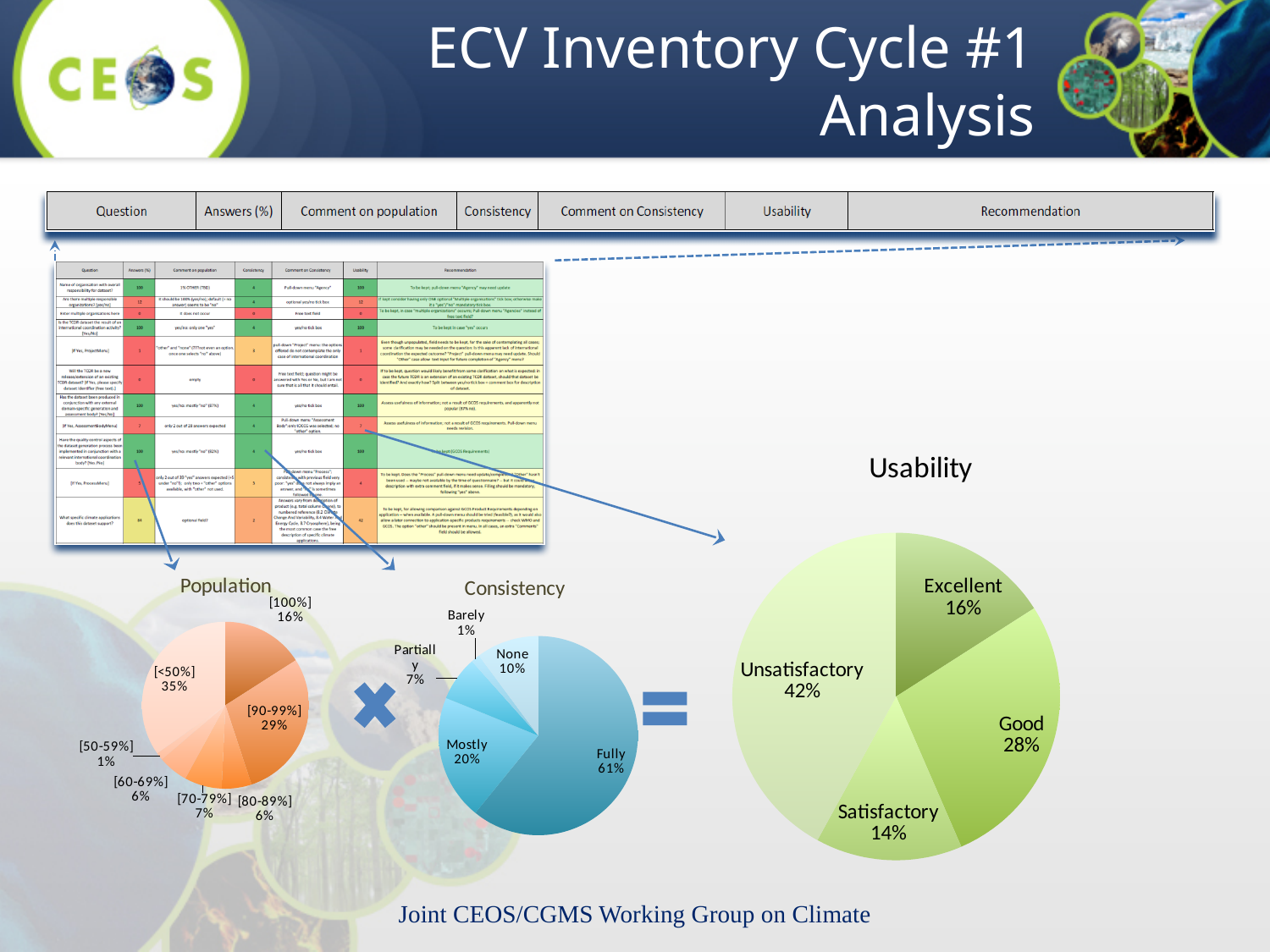
How many slices does the Consistency pie chart have? 5 In the Usability pie chart, which category has the largest share? Unsatisfactory In the Usability pie chart, which category has the smallest share? Satisfactory In the Consistency pie chart, what share is labelled Fully? 61% What type of chart is used for Population, Consistency and Usability on this slide? Pie chart How many slices does the Usability pie chart have? 4 In the Usability pie chart, what share is labelled Unsatisfactory? 42% In the Consistency pie chart, which category has the smallest share? Barely In the Usability pie chart, what is the difference between the Good and Excellent shares? 12% In the Population pie chart, which category has the largest share? [<50%] In the Population pie chart, what share is labelled [<50%]? 35% In the Consistency pie chart, which is larger, Mostly or None? Mostly